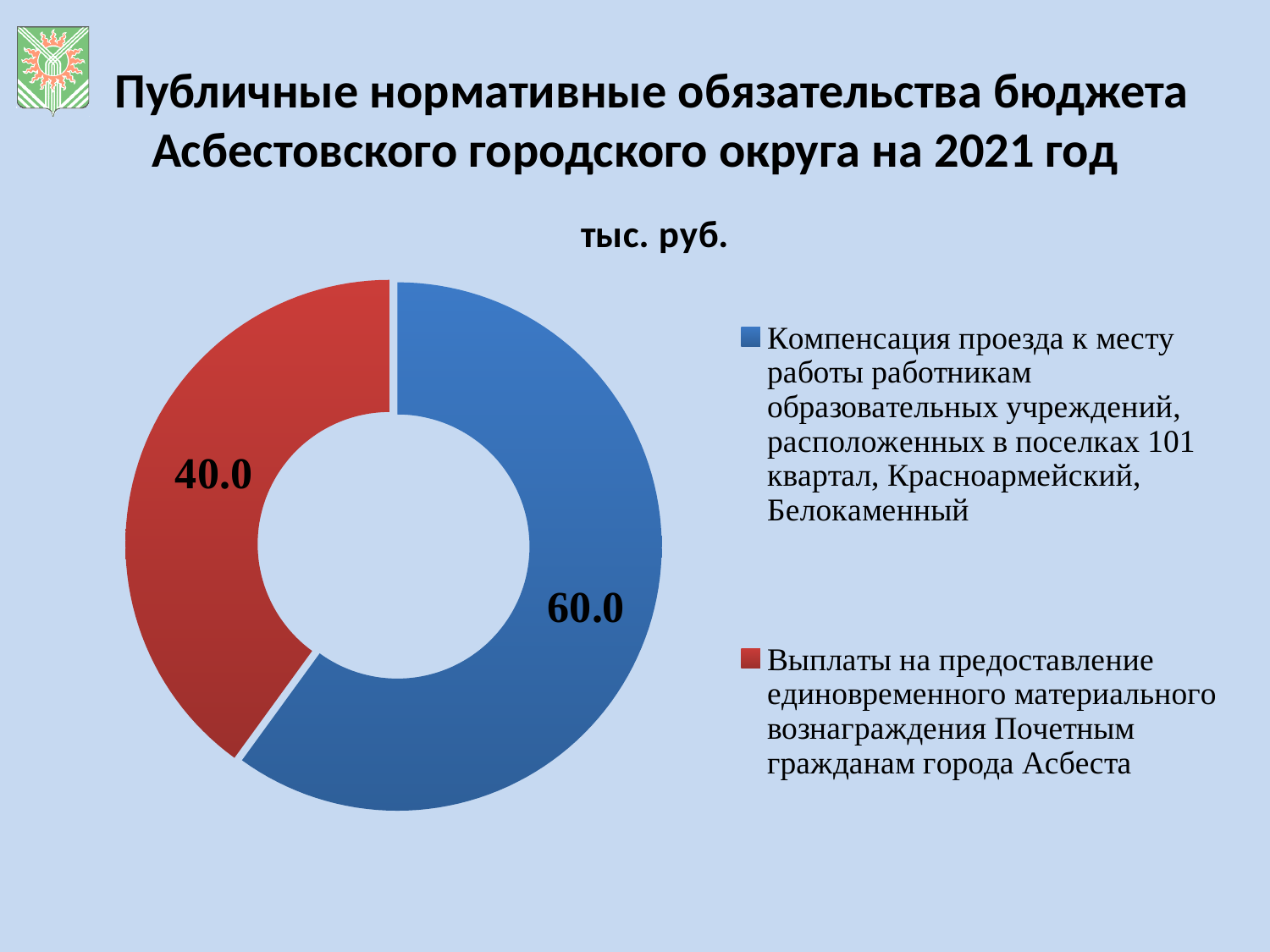
Which is larger: the value for "Компенсация проезда..." or the value for "Выплаты на предоставление..."? Компенсация проезда... What unit is shown above the chart? тыс. руб. Which category has the smallest value? Выплаты на предоставление единовременного материального вознаграждения Почетным гражданам города Асбеста What is the value for "Компенсация проезда к месту работы работникам образовательных учреждений, расположенных в поселках 101 квартал, Красноармейский, Белокаменный"? 60.0 How many categories does the chart show? 2 What share of the whole does the "Выплаты на предоставление..." slice represent? 40% What kind of chart is shown on the slide? Doughnut (pie) chart What is the difference between the value for "Компенсация проезда..." and the value for "Выплаты на предоставление..."? 20.0 Which category has the largest value? Компенсация проезда к месту работы работникам образовательных учреждений, расположенных в поселках 101 квартал, Красноармейский, Белокаменный What is the value for "Выплаты на предоставление единовременного материального вознаграждения Почетным гражданам города Асбеста"? 40.0 What is the total of the two values shown in the chart? 100.0 What colour is the slice for "Компенсация проезда..."? Blue